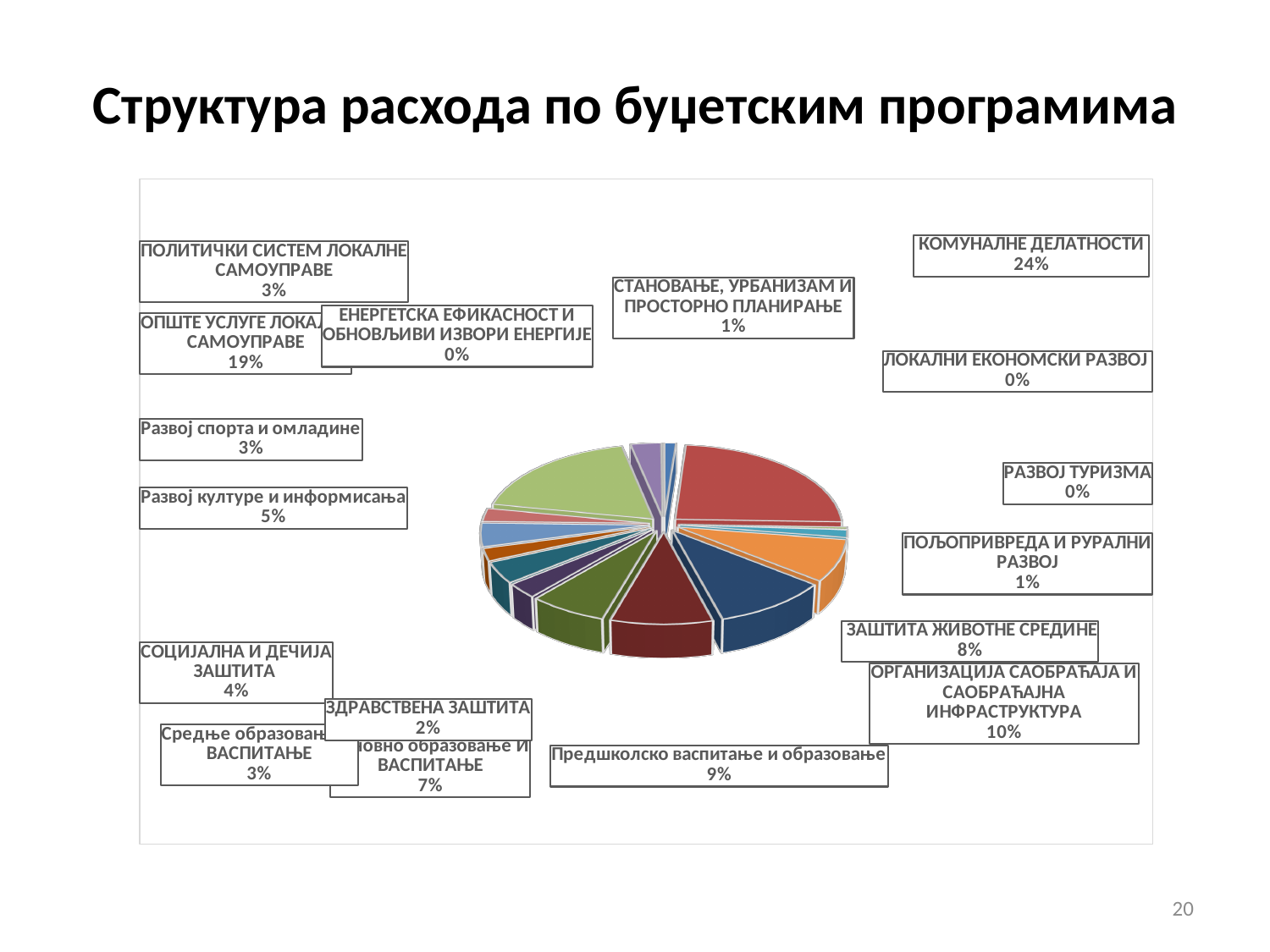
What is the value shown for СОЦИЈАЛНА И ДЕЧИЈА ЗАШТИТА? 4% What is the title of the slide? Структура расхода по буџетским програмима What is the value shown for Развој културе и информисања? 5% What is the value shown for ОРГАНИЗАЦИЈА САОБРАЋАЈА И САОБРАЋАЈНА ИНФРАСТРУКТУРА? 10% What is the value shown for Предшколско васпитање и образовање? 9% Which is larger, ЗДРАВСТВЕНА ЗАШТИТА or ЗАШТИТА ЖИВОТНЕ СРЕДИНЕ? ЗАШТИТА ЖИВОТНЕ СРЕДИНЕ What is the difference between the shares of КОМУНАЛНЕ ДЕЛАТНОСТИ and ОПШТЕ УСЛУГЕ ЛОКАЛНЕ САМОУПРАВЕ? 5% What kind of chart is shown on the slide? Pie chart Which category has the largest share of the pie? КОМУНАЛНЕ ДЕЛАТНОСТИ What is the value shown for ПОЉОПРИВРЕДА И РУРАЛНИ РАЗВОЈ? 1% What share of the pie does КОМУНАЛНЕ ДЕЛАТНОСТИ have? 24% What is the value shown for ЗАШТИТА ЖИВОТНЕ СРЕДИНЕ? 8%